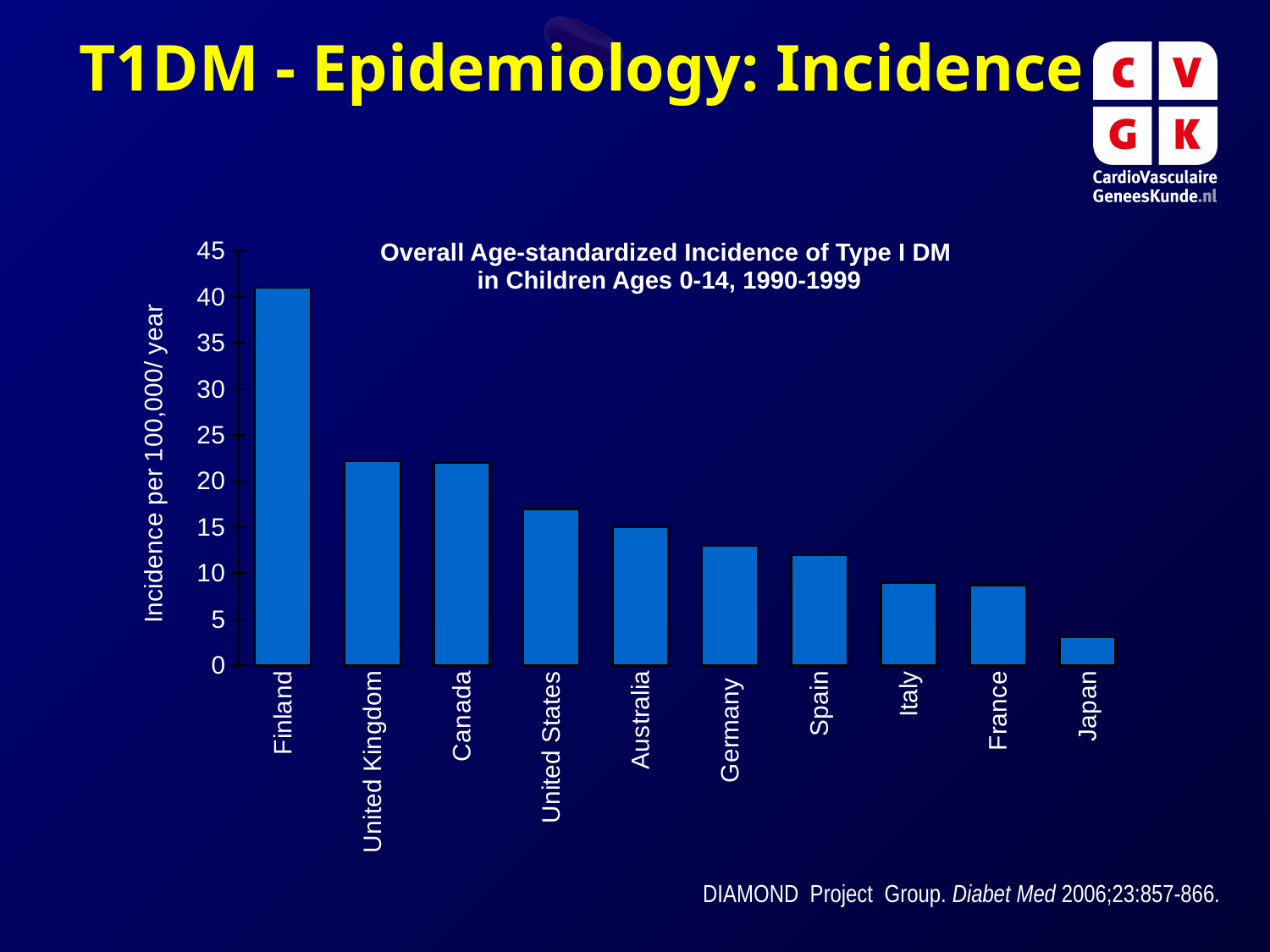
Which has a higher incidence, United States or Australia? United States Is the value for Finland greater or less than 40? greater Which country has the lowest incidence of Type I DM in the chart? Japan Is the value for Germany greater or less than 15? less Is the value for Japan greater or less than 5? less What is the label of the vertical axis of the chart? Incidence per 100,000/ year Which country has the highest incidence of Type I DM in the chart? Finland Which has a higher incidence, Spain or Japan? Spain What kind of chart is shown on the slide? bar chart Do the values rise or fall moving from left to right across the countries? fall How many countries are shown in the chart? 10